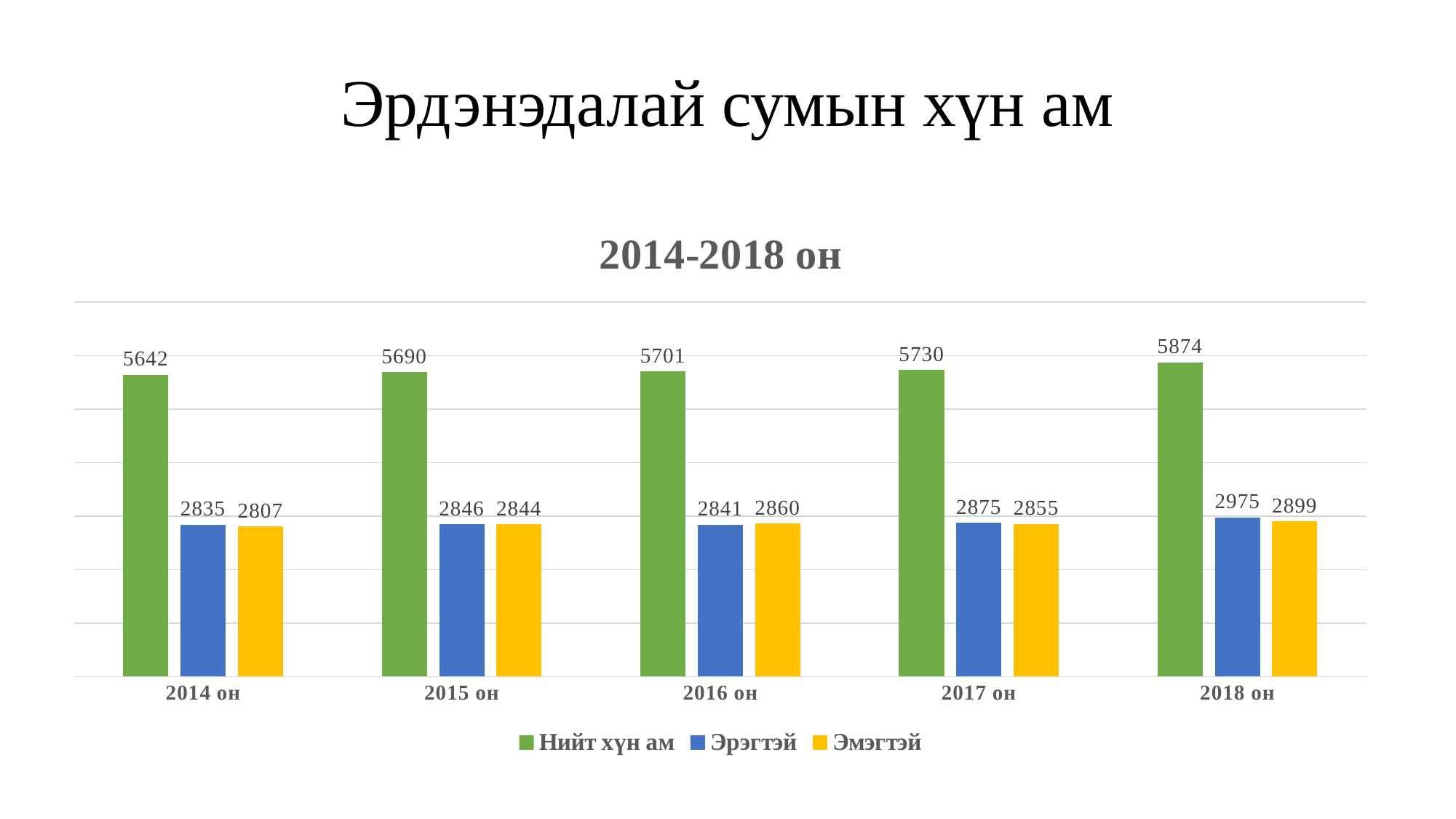
How many series does the legend list? 3 In which year is Нийт хүн ам highest? 2018 он In which year is Эмэгтэй lowest? 2014 он What kind of chart is shown? Bar chart Does Нийт хүн ам rise or fall from 2014 он to 2018 он? Rise Which is larger in 2016 он, Эрэгтэй or Эмэгтэй? Эмэгтэй What is the value of Эмэгтэй for 2016 он? 2860 What is the value of Эрэгтэй for 2018 он? 2975 How many years are shown on the x axis? 5 What is the title of the chart? 2014-2018 он What is the difference between Нийт хүн ам in 2018 он and 2014 он? 232 What is the value of Нийт хүн ам for 2014 он? 5642